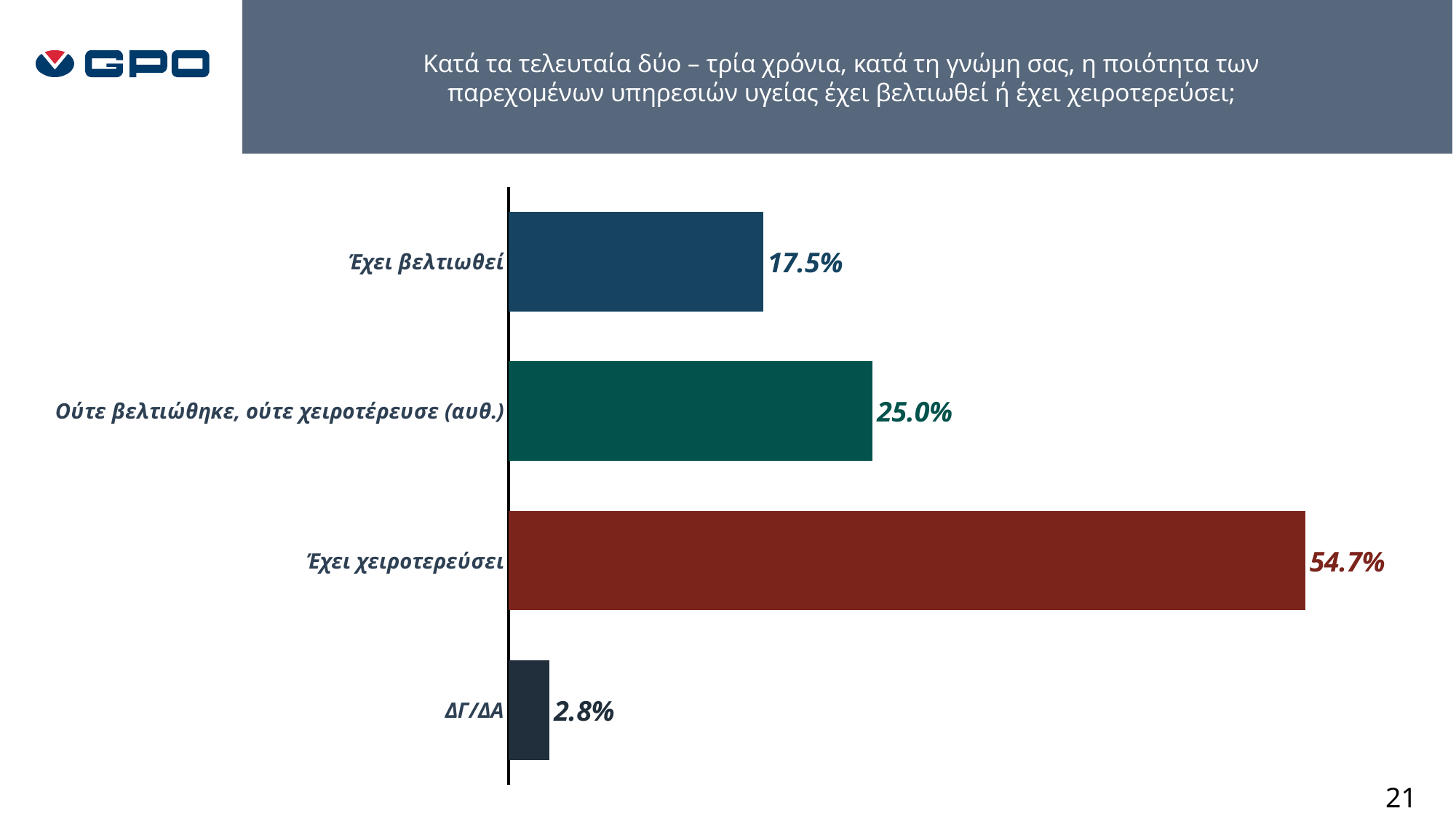
What is the value for Έχει χειροτερεύσει? 54.7% Which category has the lowest value? ΔΓ/ΔΑ What is the value for Έχει βελτιωθεί? 17.5% What is the value for ΔΓ/ΔΑ? 2.8% What kind of chart is shown on the slide? Bar chart What is the difference between the values for Έχει χειροτερεύσει and Έχει βελτιωθεί? 37.2% What is the value for Ούτε βελτιώθηκε, ούτε χειροτέρευσε (αυθ.)? 25.0% Which category has the highest value? Έχει χειροτερεύσει How many categories are shown in the chart? 4 What colour is the bar for Έχει χειροτερεύσει? Dark red Which is larger, the value for Έχει βελτιωθεί or the value for Ούτε βελτιώθηκε, ούτε χειροτέρευσε (αυθ.)? Ούτε βελτιώθηκε, ούτε χειροτέρευσε (αυθ.) What is the difference between the values for Ούτε βελτιώθηκε, ούτε χειροτέρευσε (αυθ.) and Έχει βελτιωθεί? 7.5%